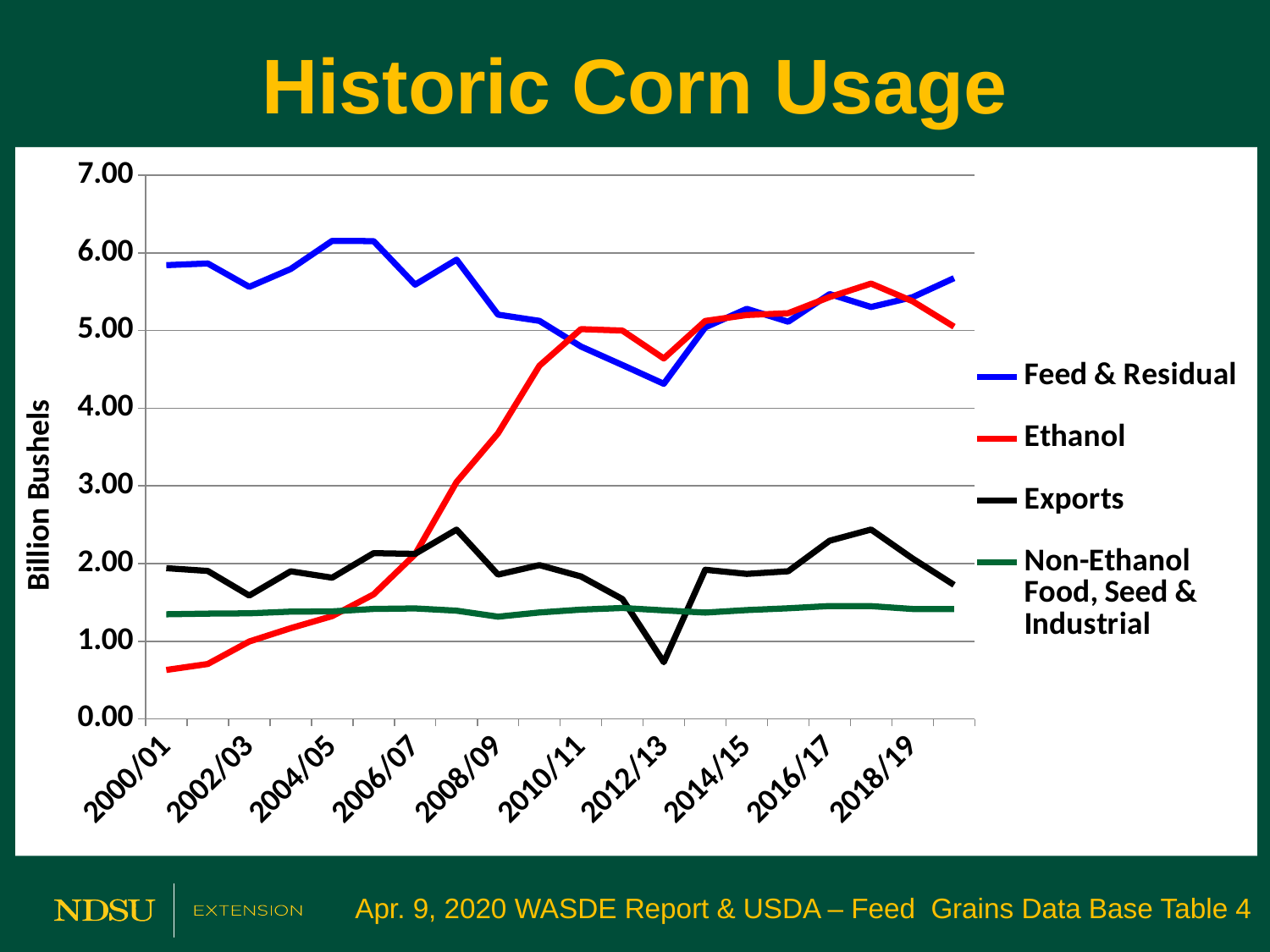
In 2008/09, which is larger: Exports or Non-Ethanol Food, Seed & Industrial? Exports Is the value for Feed & Residual in 2012/13 greater or less than 5.00? less What is the label on the y axis? Billion Bushels What colour is the Ethanol line? Red Is the value for Feed & Residual in 2000/01 greater or less than 5.00? greater Which series has the lowest value in 2012/13? Exports Is the value for Exports in 2012/13 greater or less than 1.00? less How many series does the legend list? 4 Which series has the highest value in 2000/01? Feed & Residual What kind of chart is shown on the slide? Line chart Does the Ethanol line rise or fall overall from 2000/01 to 2018/19? Rise